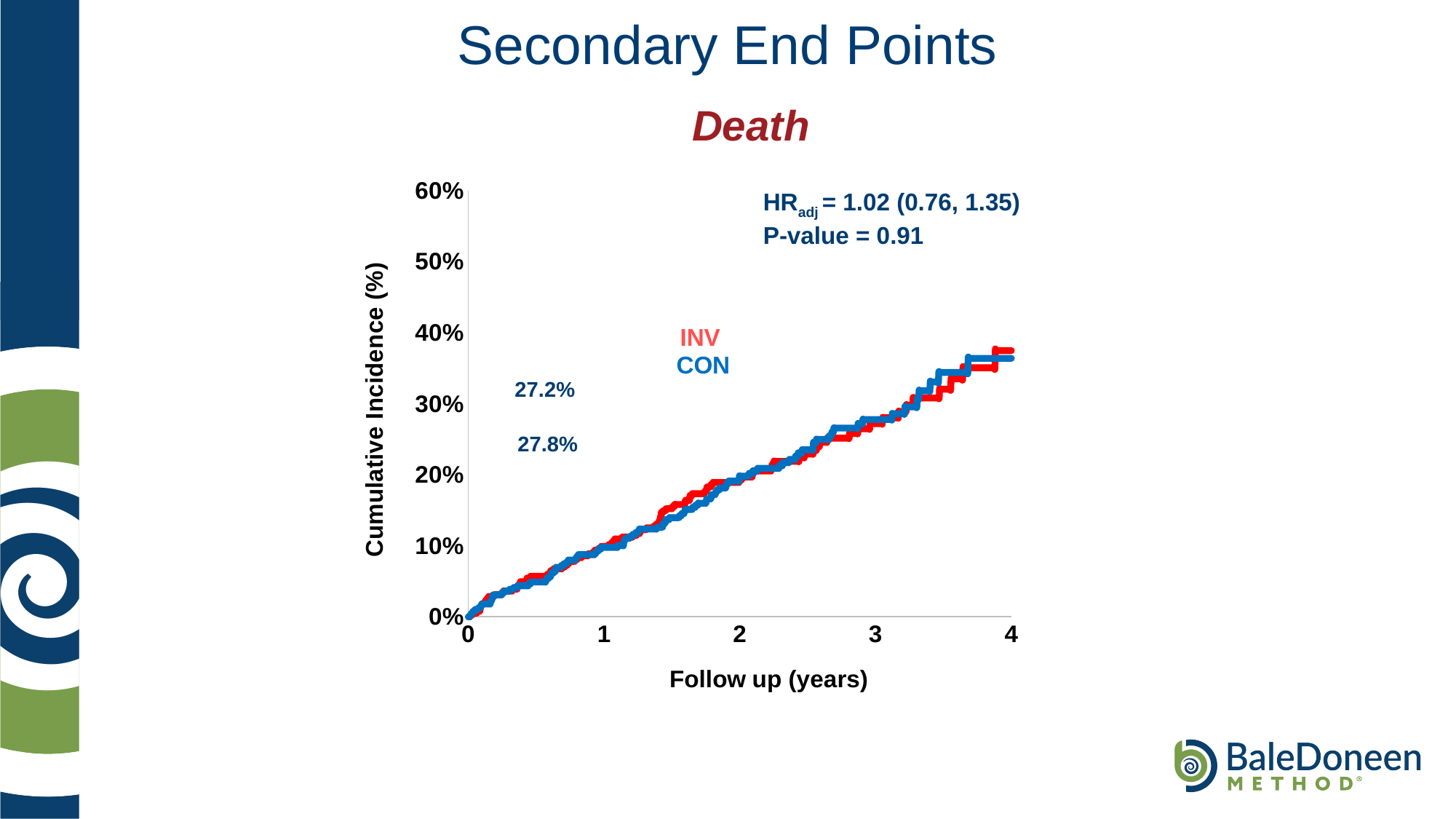
Is the value for CON at 4 years of follow up greater or less than 30%? greater What kind of chart is shown on the slide? line chart What are the names of the two series plotted on the chart? INV and CON What P-value is shown on the chart? 0.91 Is the value for CON at 1 year of follow up greater or less than 20%? less What is the adjusted hazard ratio shown on the chart? 1.02 (0.76, 1.35) What is the label of the y axis? Cumulative Incidence (%) Is the value for INV at 4 years of follow up greater or less than 40%? less What is the highest value shown on the y axis? 60% Do the cumulative incidence curves rise or fall as follow-up years increase? rise How many series are plotted on the chart? 2